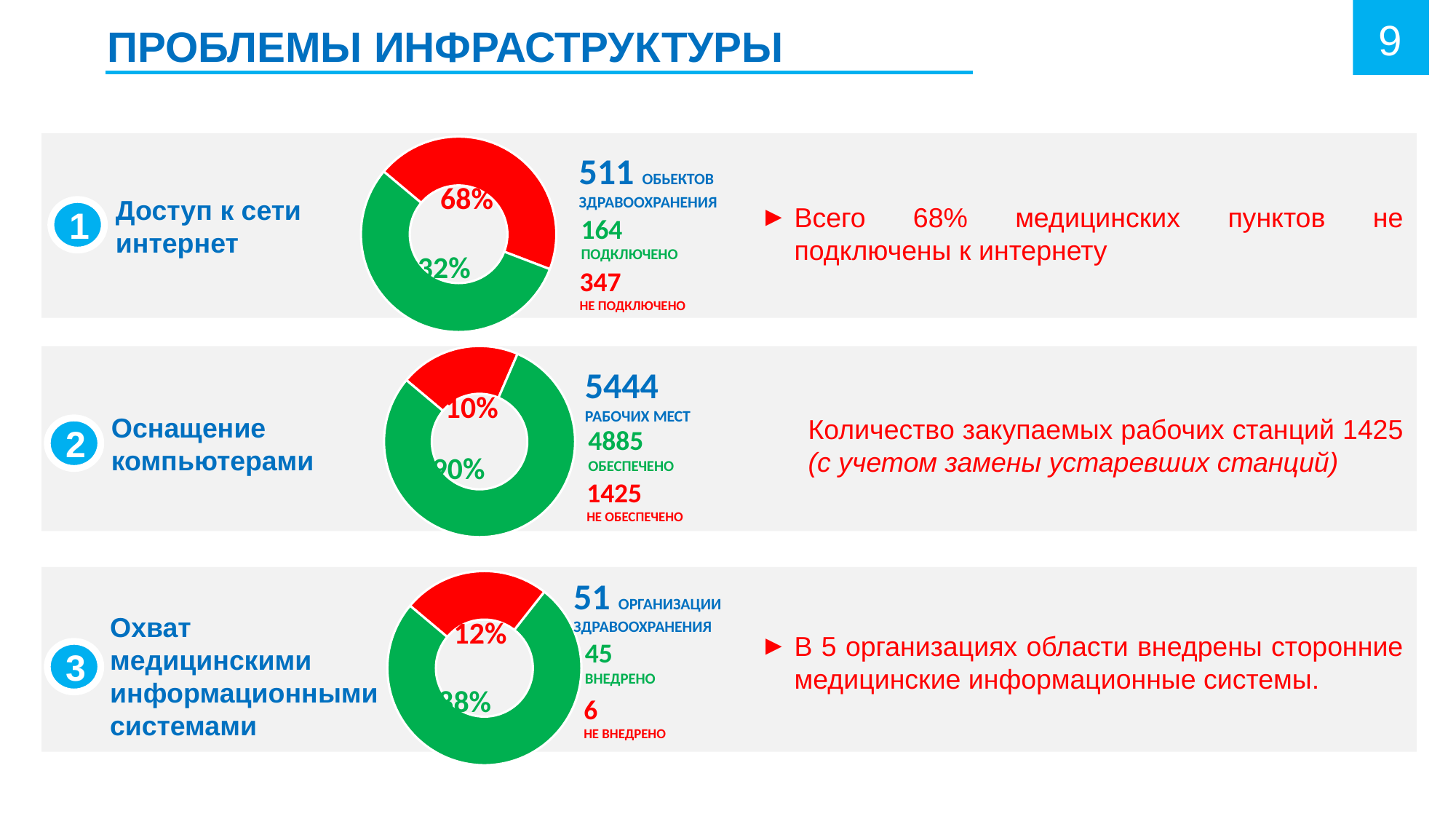
In the middle chart (Оснащение компьютерами), which is larger: 'обеспечено' or 'не обеспечено'? обеспечено In the bottom chart (Охват медицинскими информационными системами), how many organisations are labelled 'внедрено'? 45 In the middle chart (Оснащение компьютерами), how many workplaces are labelled 'не обеспечено'? 1425 In the top chart (Доступ к сети интернет), what percentage is shown for the red slice? 68% In the middle chart (Оснащение компьютерами), what percentage is shown for the green slice? 90% How many slices does each donut chart on the slide have? 2 In the top chart (Доступ к сети интернет), what is the difference between 'не подключено' and 'подключено'? 183 In the top chart (Доступ к сети интернет), how many objects are labelled 'подключено'? 164 In the bottom chart (Охват медицинскими информационными системами), what percentage is shown for the red slice? 12% What kind of chart is used in the top row (Доступ к сети интернет)? Donut (pie) chart In the bottom chart (Охват медицинскими информационными системами), what is the difference between 'внедрено' and 'не внедрено'? 39 In the top chart (Доступ к сети интернет), how many objects are labelled 'не подключено'? 347